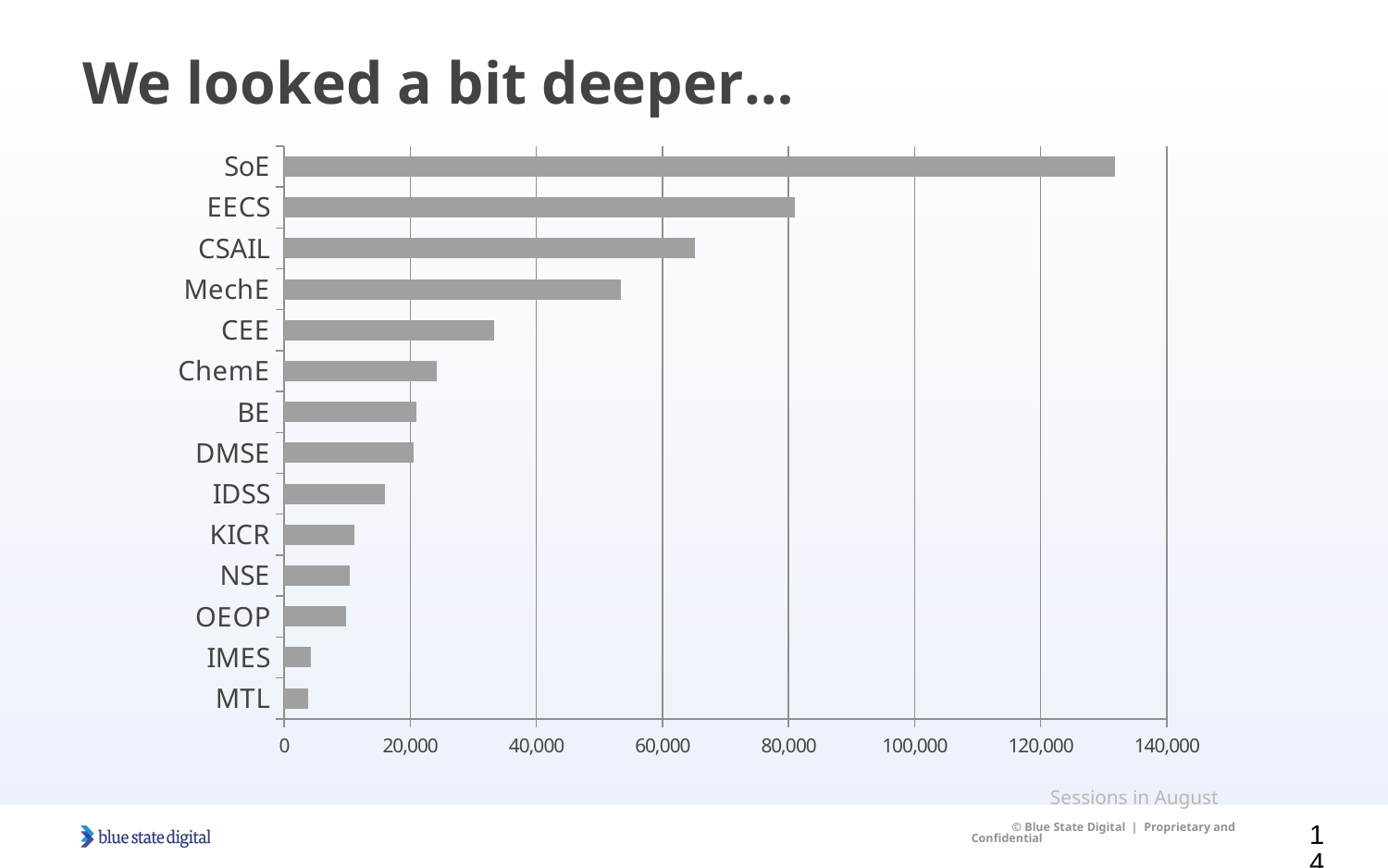
Which has a larger value, EECS or CSAIL? EECS What kind of chart is shown on the slide? bar chart Is the value for CSAIL greater or less than 60,000? greater Is the value for CEE greater or less than 20,000? greater Is the value for SoE greater or less than 120,000? greater How many categories are plotted in the chart? 14 What is the label shown below the horizontal axis of the chart? Sessions in August Which has a larger value, CEE or ChemE? CEE What is the title of the slide containing the chart? We looked a bit deeper… Which category has the highest value in the chart? SoE